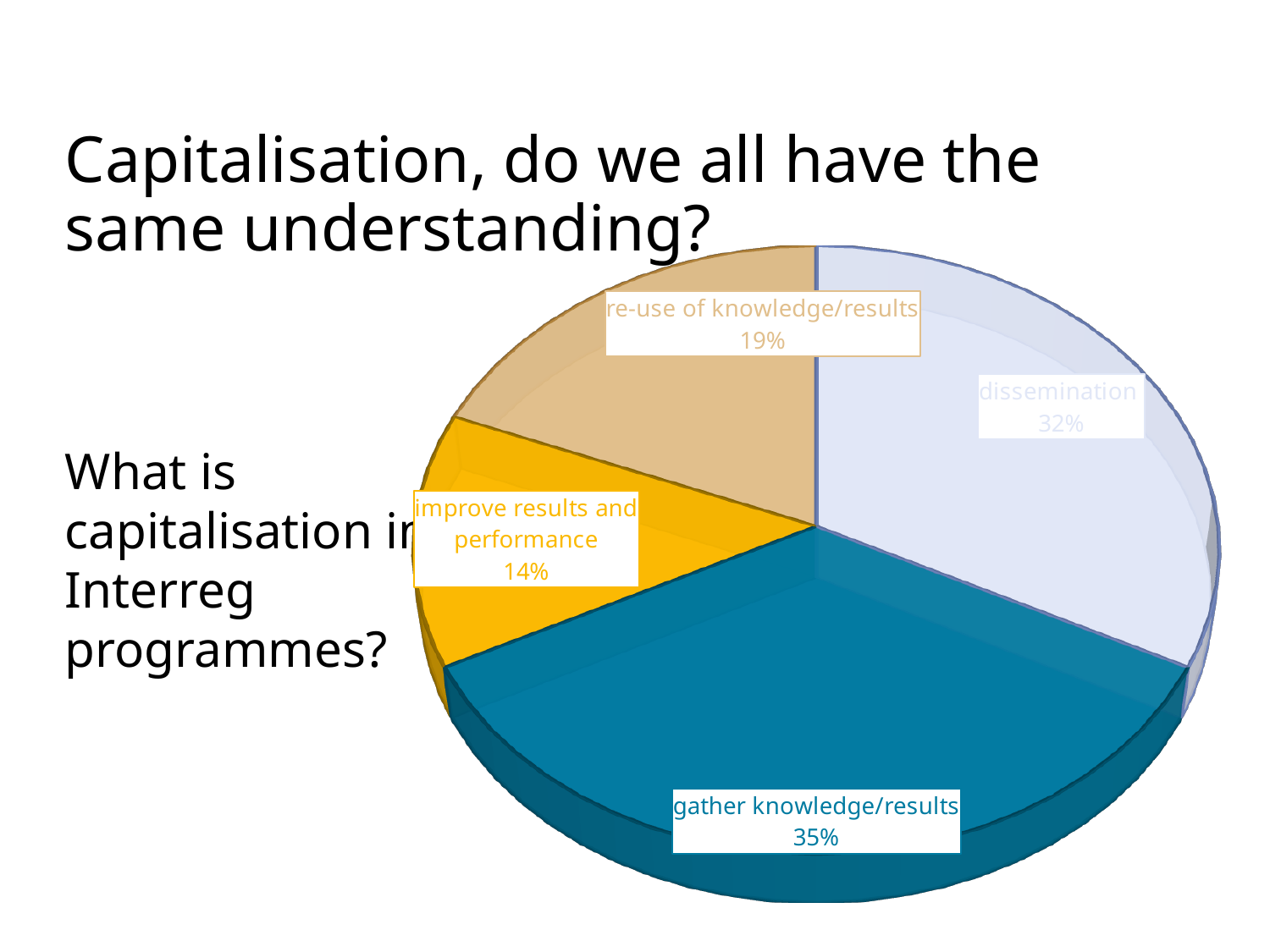
What kind of chart is shown on the slide? pie chart What share of the pie does 'improve results and performance' represent? 14% Which slice of the pie is the smallest? improve results and performance What is the difference in percentage points between 'gather knowledge/results' and 'dissemination'? 3% What colour is the 'gather knowledge/results' slice? blue Which slice of the pie is the largest? gather knowledge/results Which is larger: the share for 'dissemination' or the share for 're-use of knowledge/results'? dissemination What is the difference in percentage points between 're-use of knowledge/results' and 'improve results and performance'? 5% What share of the pie does 'gather knowledge/results' represent? 35% How many slices does the pie chart have? 4 What share of the pie does 're-use of knowledge/results' represent? 19%